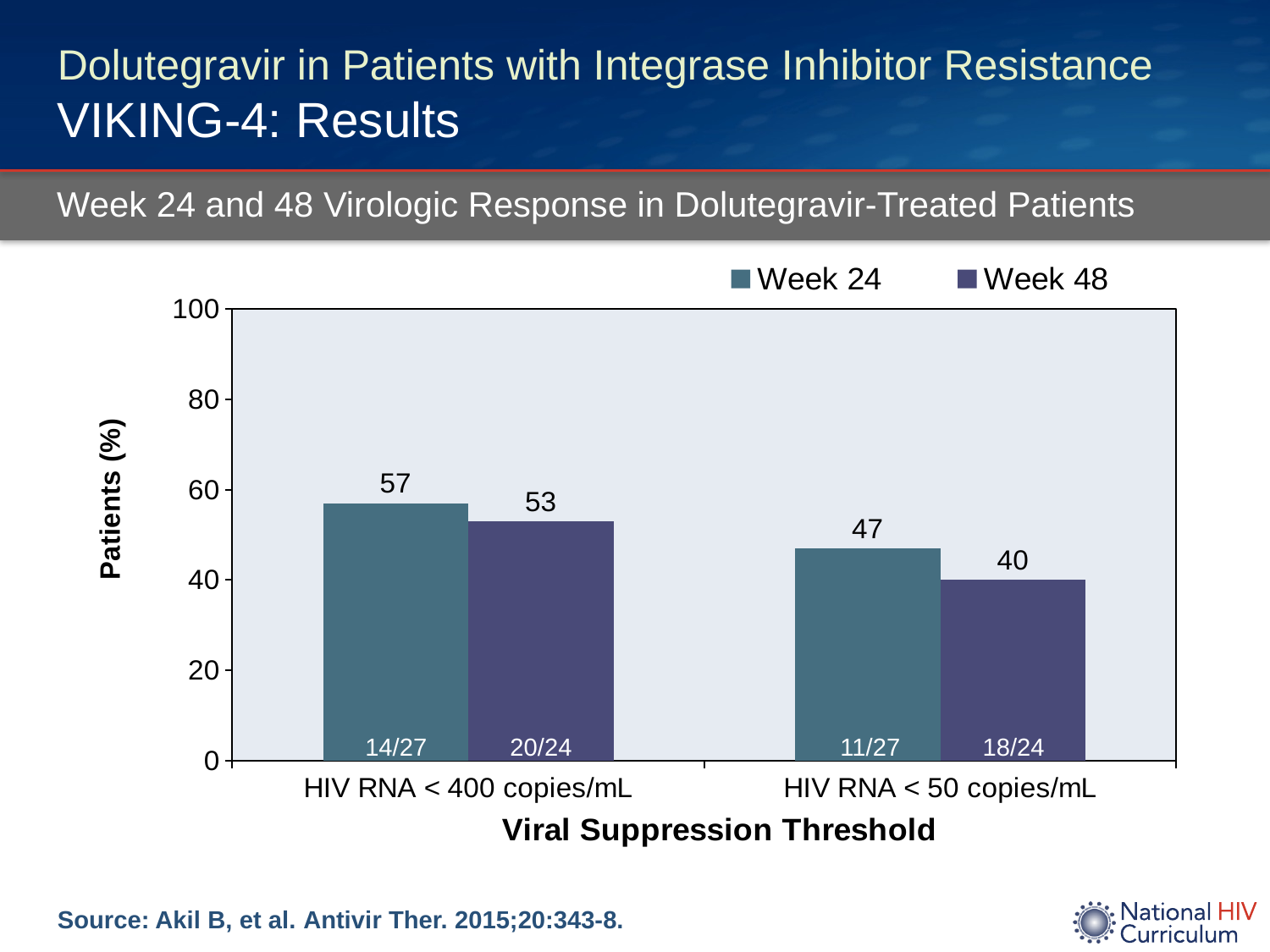
What is the Week 24 value for HIV RNA < 50 copies/mL? 47 What is the difference between the Week 24 and Week 48 values for HIV RNA < 50 copies/mL? 7 What kind of chart is shown on the slide? Bar chart Which bar has the lowest value on the chart? Week 48, HIV RNA < 50 copies/mL What is the Week 48 value for HIV RNA < 400 copies/mL? 53 What percentage of patients had HIV RNA < 50 copies/mL at Week 48? 40 Which bar has the highest value on the chart? Week 24, HIV RNA < 400 copies/mL How many series does the legend list? 2 What is the label of the y axis? Patients (%) What percentage of patients had HIV RNA < 400 copies/mL at Week 24? 57 How many categories are shown on the x axis? 2 Which is larger: the Week 24 value for HIV RNA < 400 copies/mL or the Week 24 value for HIV RNA < 50 copies/mL? HIV RNA < 400 copies/mL